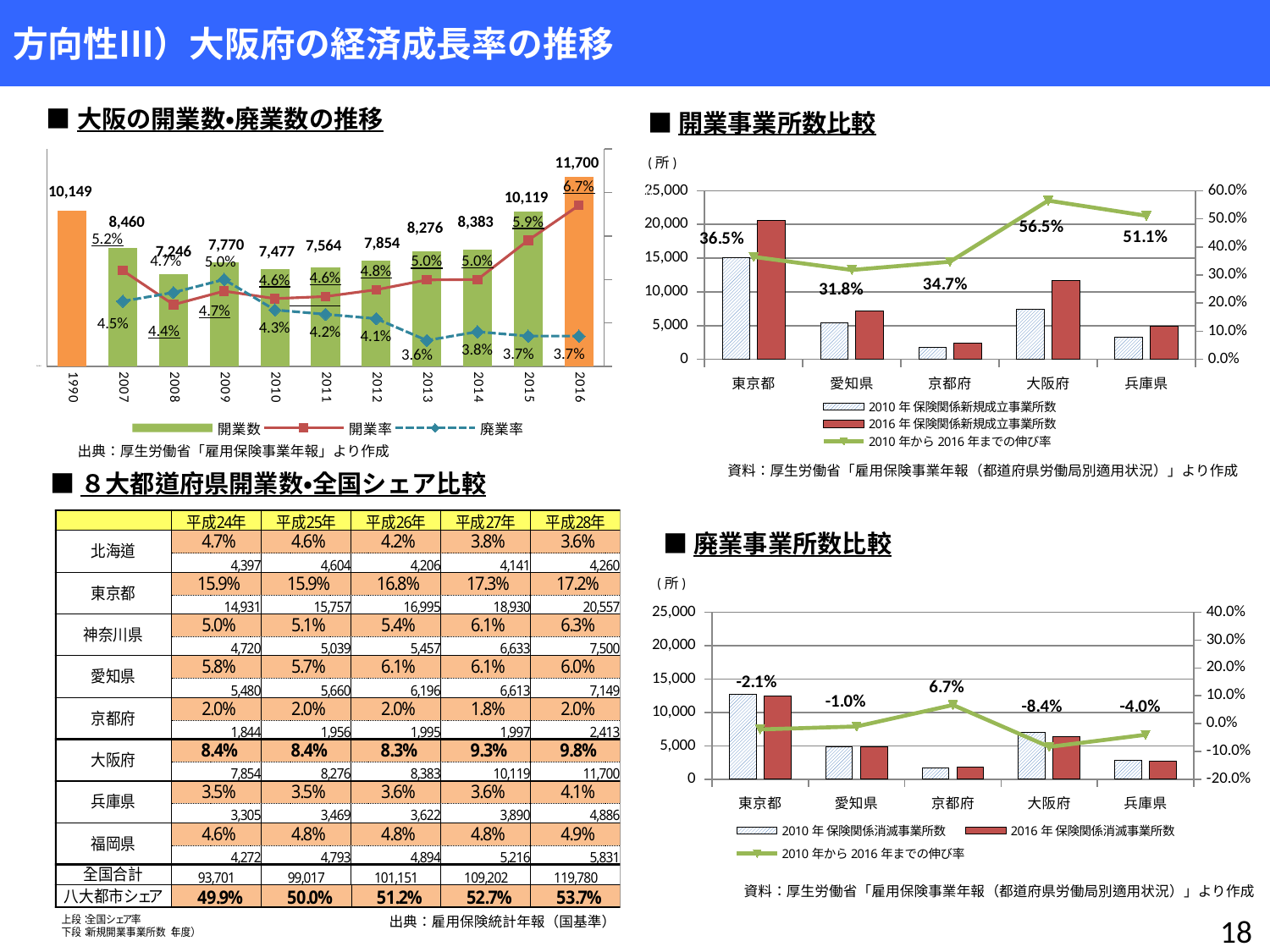
In the chart titled 大阪の開業数・廃業数の推移, what is the difference in 開業数 between 2016 and 2015? 1,581 In the chart titled 開業事業所数比較, is the 2016年 bar for 大阪府 greater or less than 10,000? greater In the chart titled 大阪の開業数・廃業数の推移, does the 廃業率 line generally rise or fall from 2007 to 2016? fall In the chart titled 大阪の開業数・廃業数の推移, which year has the lowest 開業数 bar? 2008 In the chart titled 廃業事業所数比較, what is the 伸び率 for 兵庫県? -4.0% In the chart titled 廃業事業所数比較, which prefecture has the highest 伸び率? 京都府 In the chart titled 大阪の開業数・廃業数の推移, how many series does the legend list? 3 In the chart titled 開業事業所数比較, which prefecture has the lowest 伸び率? 愛知県 In the chart titled 大阪の開業数・廃業数の推移, what is the 開業率 for 2015? 5.9% In the chart titled 開業事業所数比較, what is the 2010年から2016年までの伸び率 for 大阪府? 56.5% In the chart titled 大阪の開業数・廃業数の推移, what is the 開業数 value for 2016? 11,700 In the chart titled 廃業事業所数比較, how many prefectures are shown on the x axis? 5